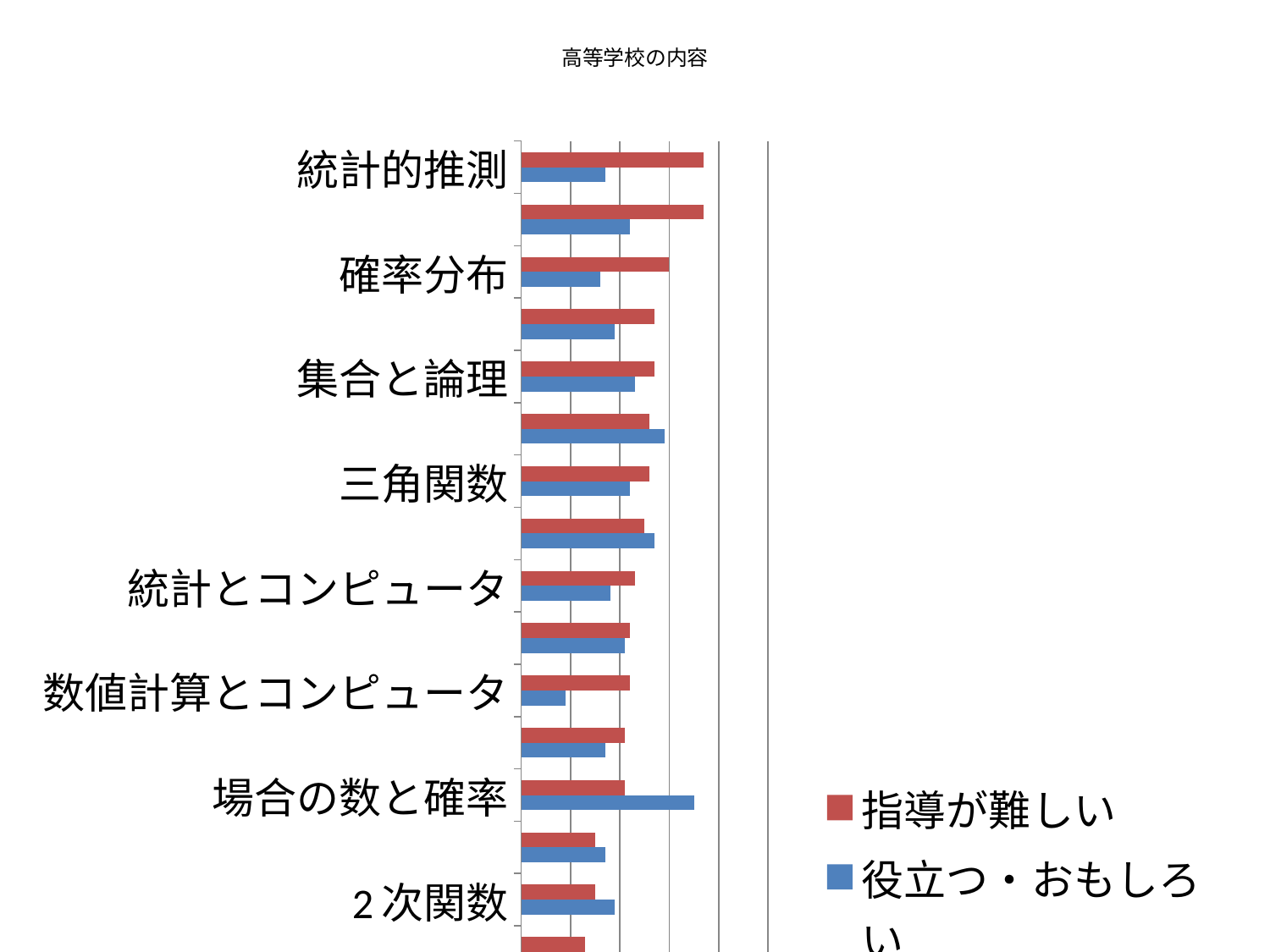
For 確率分布, which series has the larger value, 指導が難しい or 役立つ・おもしろい? 指導が難しい For 数値計算とコンピュータ, which series has the larger value, 指導が難しい or 役立つ・おもしろい? 指導が難しい Which series is shown in red in the legend? 指導が難しい For 場合の数と確率, which series has the larger value, 指導が難しい or 役立つ・おもしろい? 役立つ・おもしろい Among the labelled categories, which has the highest value for 役立つ・おもしろい? 場合の数と確率 Among the labelled categories, which has the highest value for 指導が難しい? 統計的推測 Among the labelled categories, which has the lowest value for 役立つ・おもしろい? 数値計算とコンピュータ What kind of chart is shown on the slide? bar chart How many series does the legend list? 2 What is the title of the chart? 高等学校の内容